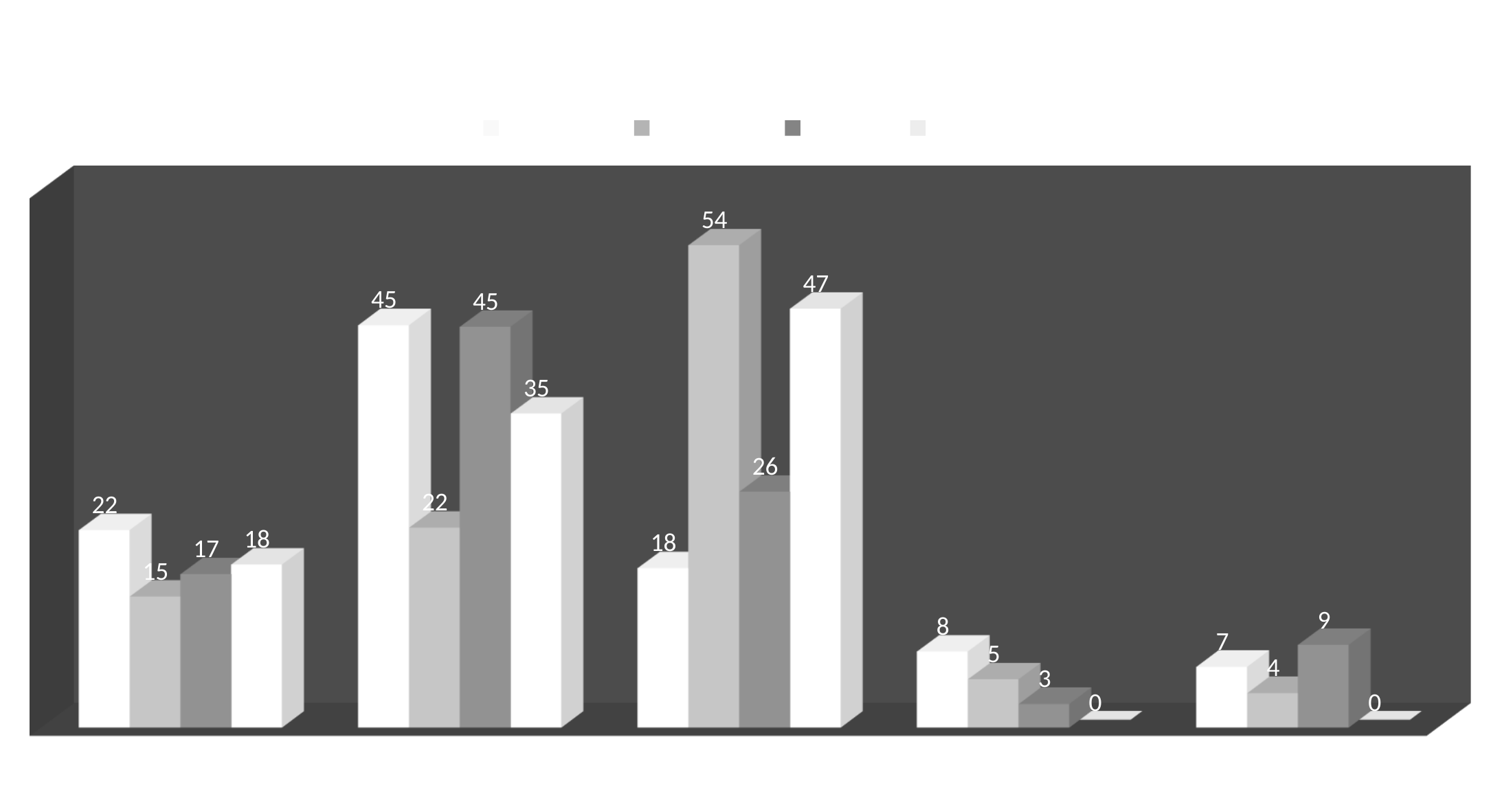
What is the lowest value in the fourth group from the left? 0 In the third group from the left, what is the difference between the second bar (54) and the third bar (26)? 28 How many series does the legend above the chart list? 4 What is the value of the fourth (rightmost) bar in the third group from the left? 47 What is the value of the first (leftmost) bar in the second group from the left? 45 What is the highest value labelled anywhere in the chart? 54 What is the total of the four bars in the first group from the left (22, 15, 17, 18)? 72 How many groups of bars are plotted in the chart? 5 What is the value of the third bar in the fifth (rightmost) group? 9 What kind of chart is shown on the slide? bar chart In the second group from the left, what is the difference between the first bar (45) and the fourth bar (35)? 10 In the first group from the left, which is larger: the first bar or the second bar? the first bar